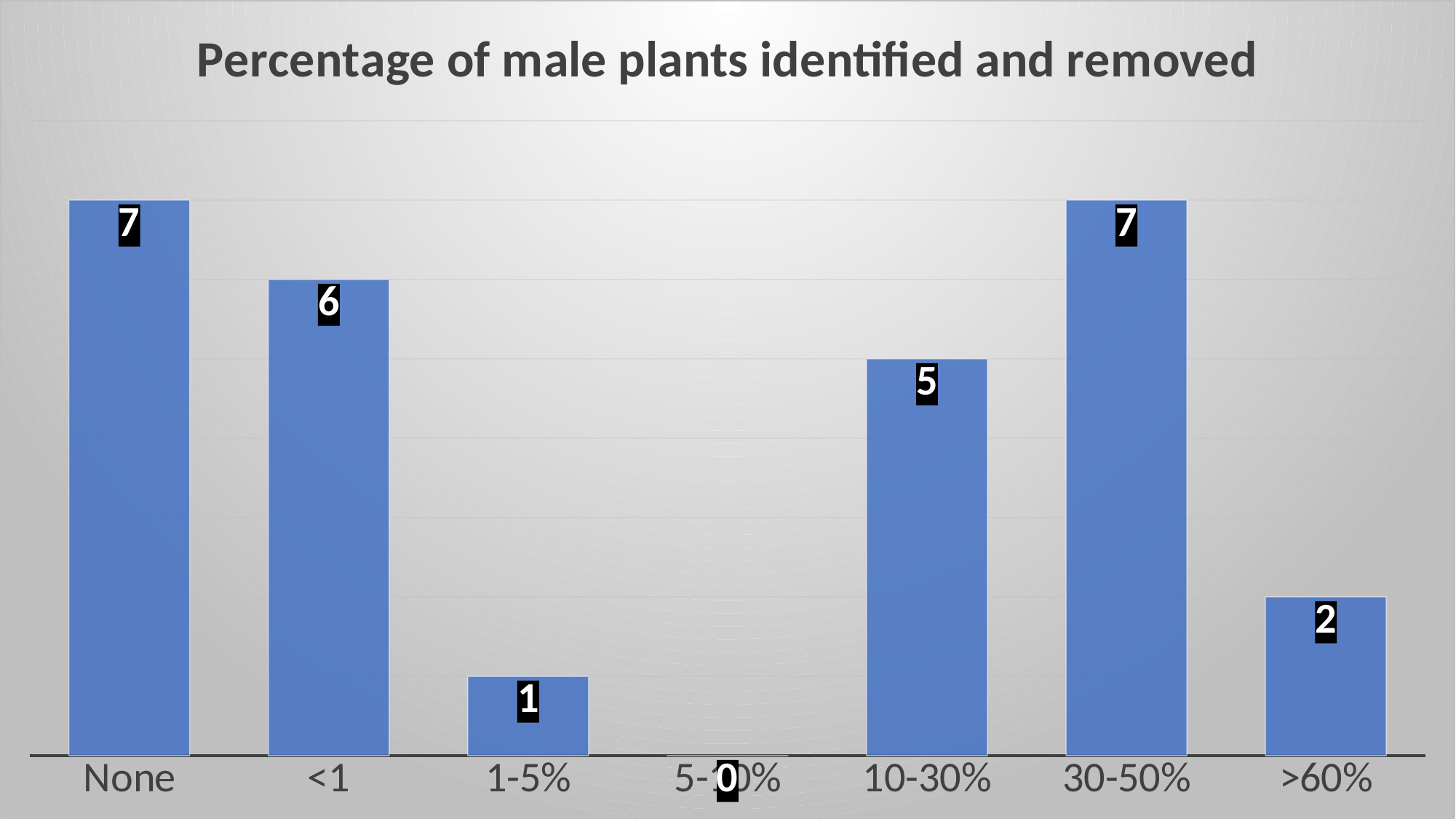
Which category has the lowest value? 5-10% What is the title of the chart? Percentage of male plants identified and removed What is the value for the '1-5%' category? 1 What type of chart is shown on the slide? bar chart What is the value for the '<1' category? 6 Which is larger, the value for '30-50%' or the value for '>60%'? 30-50% What is the difference between the values for '<1' and '10-30%'? 1 What is the value for the '>60%' category? 2 What is the value for the 'None' category? 7 How many categories are shown on the x axis? 7 What is the difference between the values for 'None' and '1-5%'? 6 What is the value for the '10-30%' category? 5